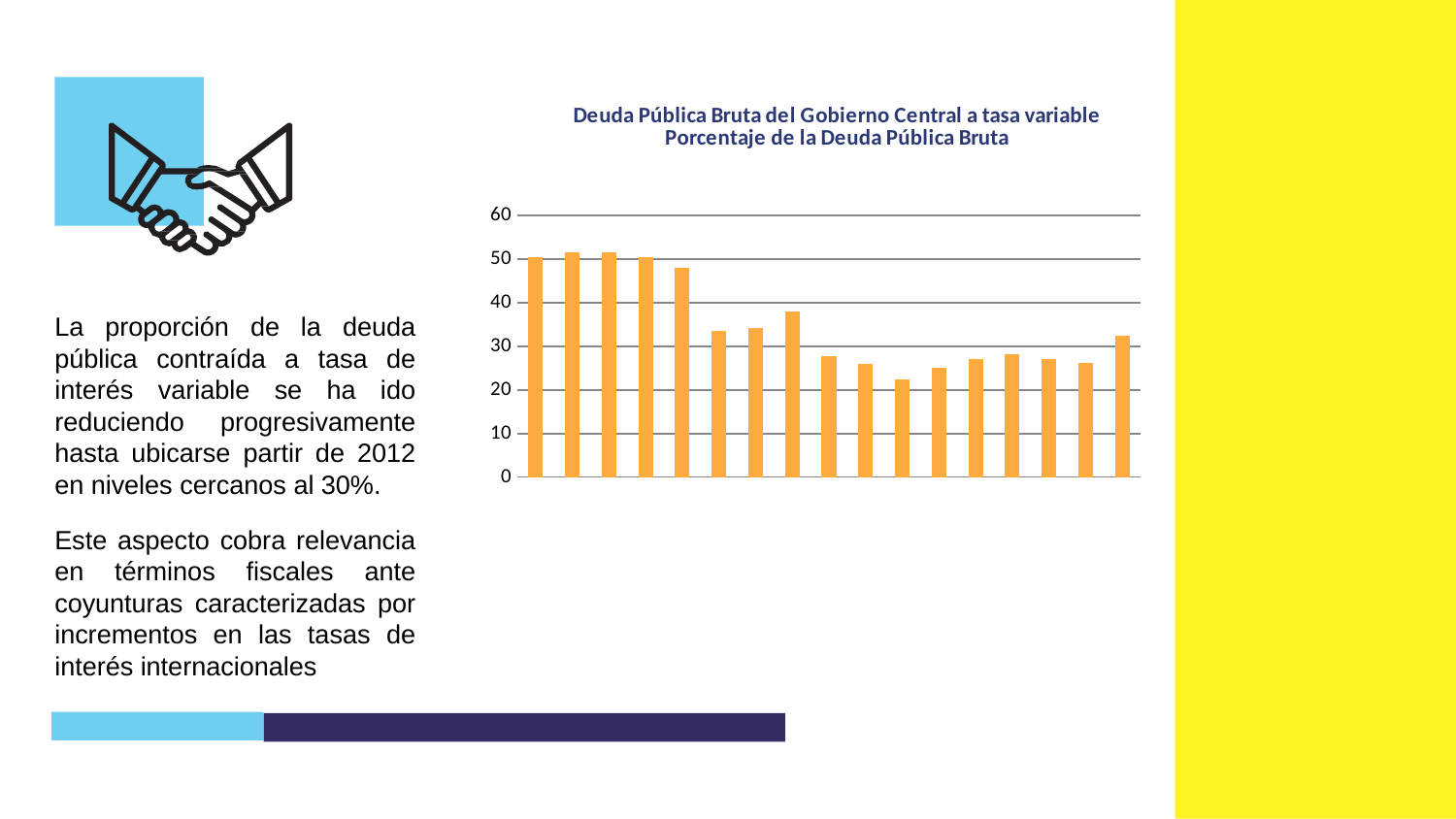
What kind of chart is shown on the slide? bar chart What is the highest value shown on the vertical axis? 60 Which is larger, the first bar or the last bar? the first bar How many bars are plotted in the chart? 17 Is the value of the last (rightmost) bar greater or less than 30? greater Is the value of the first (leftmost) bar greater or less than 40? greater What is the title of the chart? Deuda Pública Bruta del Gobierno Central a tasa variable Porcentaje de la Deuda Pública Bruta Do the values in the chart generally rise or fall from left to right? fall Is the value of the sixth bar from the left greater or less than 40? less